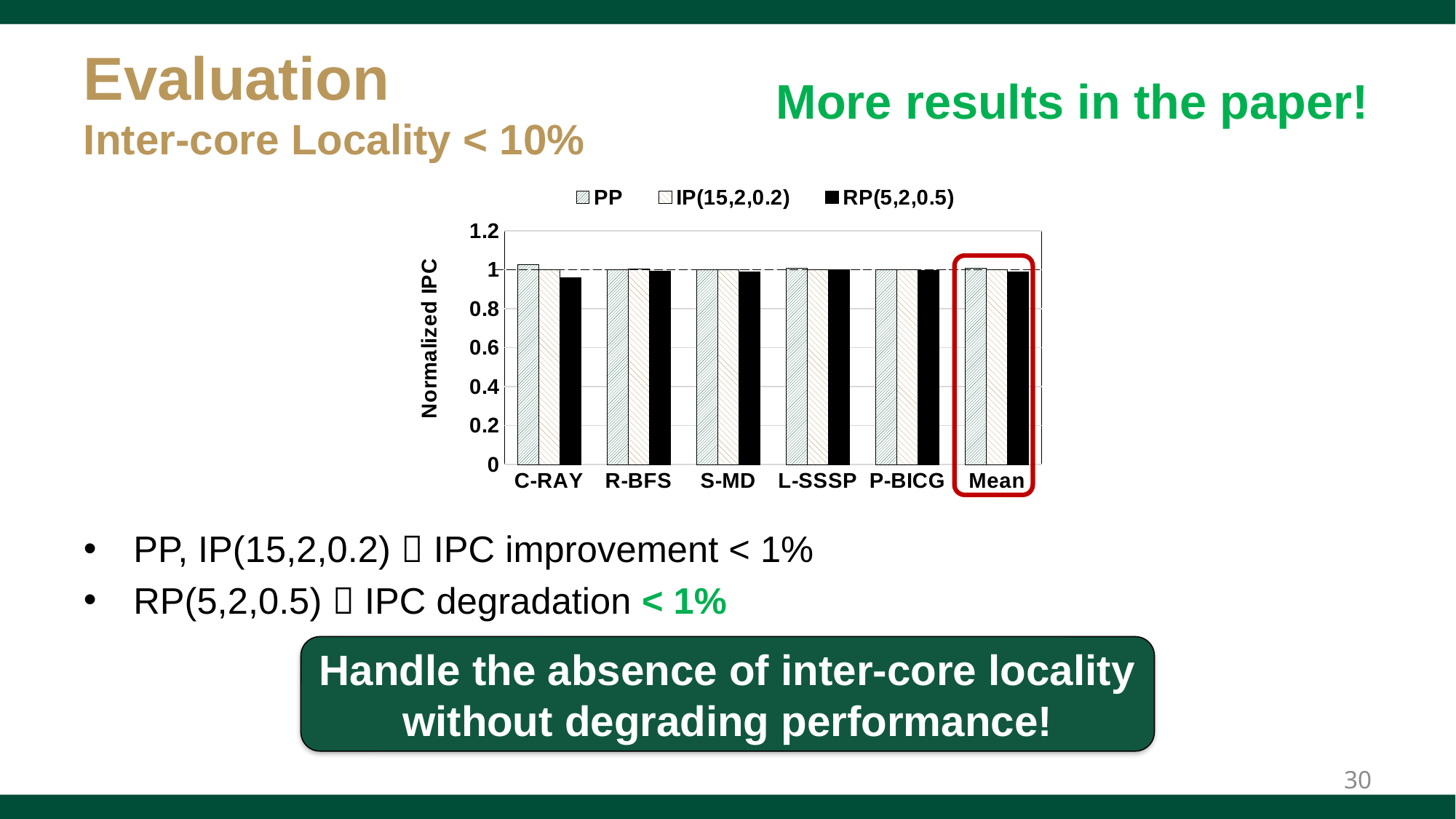
Is the PP value for L-SSSP greater or less than 0.2? greater How many categories are shown on the x axis of the chart? 6 Is the IP(15,2,0.2) value for Mean greater or less than 0.6? greater Is the RP(5,2,0.5) value for C-RAY greater or less than 0.8? greater How many series does the chart's legend list? 3 What kind of chart is shown on the slide? bar chart Which series in the legend is drawn with solid black bars? RP(5,2,0.5) Which category on the x axis is highlighted with a red box? Mean What is the label of the y axis of the chart? Normalized IPC